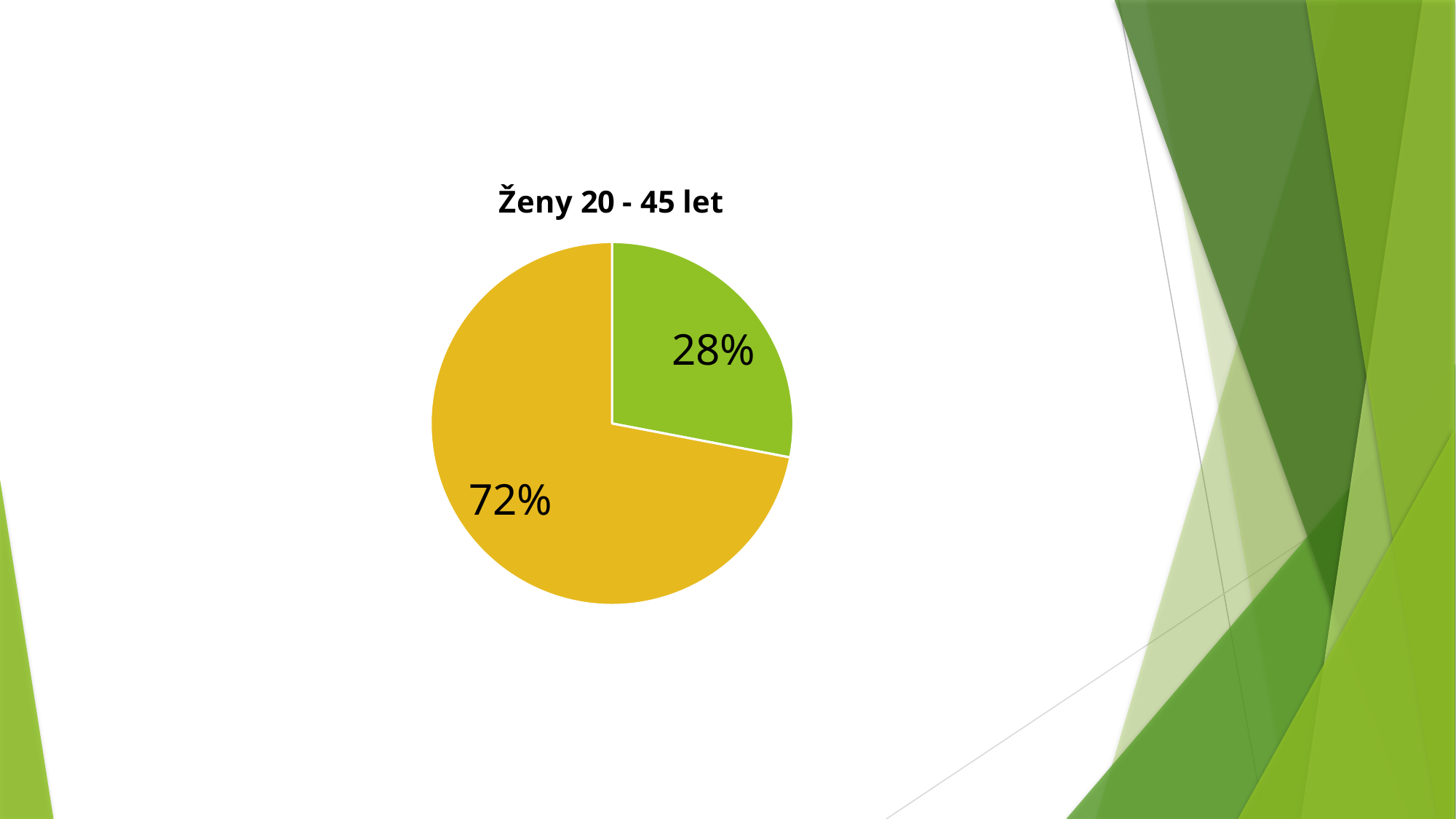
Which slice is the smallest in the pie chart? the green slice (28%) Which slice is the largest in the pie chart? the yellow slice (72%) What is the title of the chart? Ženy 20 - 45 let What share of the pie does the yellow slice represent? 72% Is the value of the yellow slice greater or less than 50%? greater What colour is the slice labelled 28%? green Is the value of the green slice greater or less than 50%? less What share of the pie does the green slice represent? 28% What is the difference in percentage points between the yellow slice and the green slice? 44 Which is larger, the green slice or the yellow slice? the yellow slice What kind of chart is shown on the slide? pie chart How many slices does the pie chart have? 2